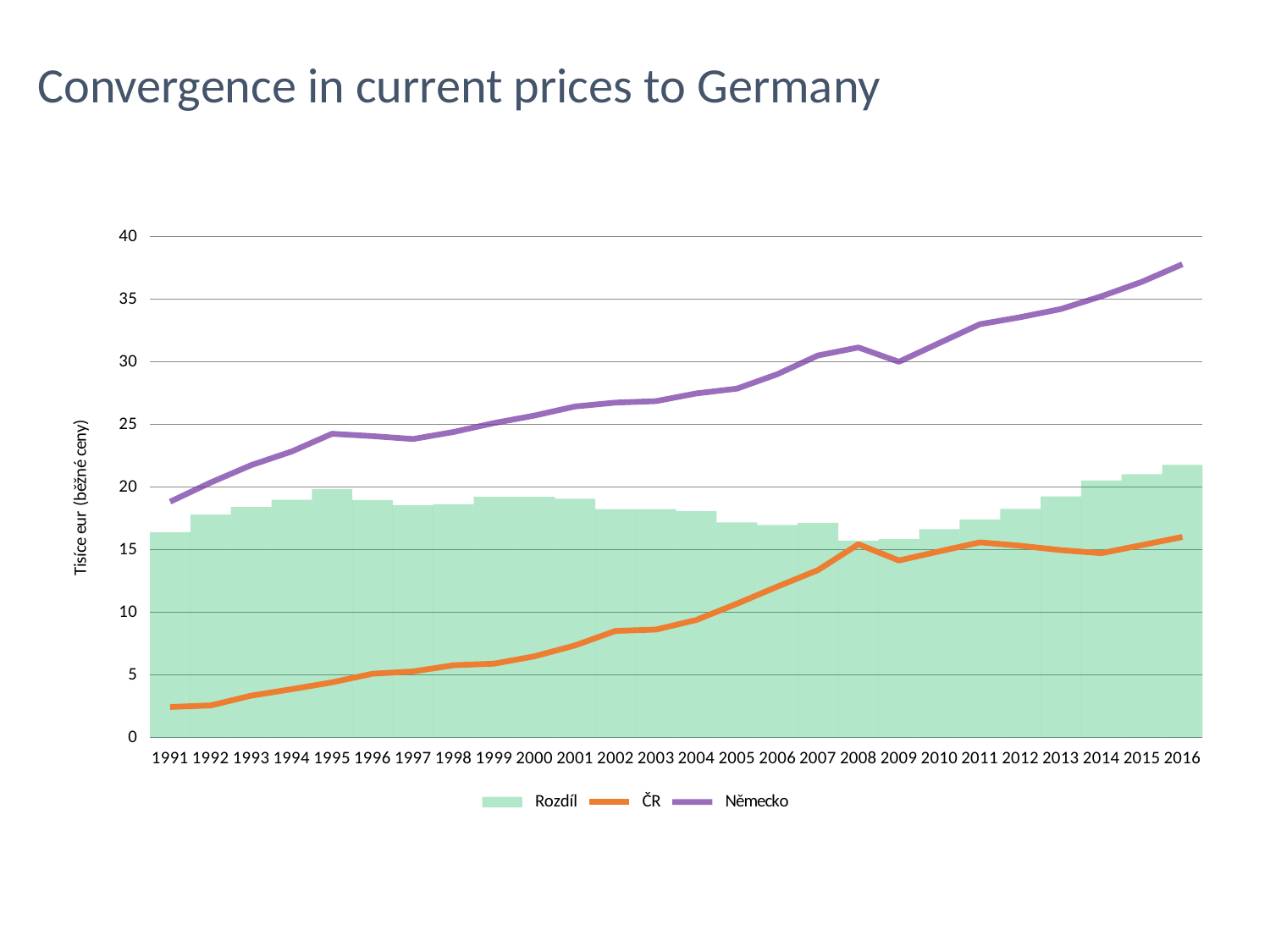
Which is larger in 2016, the value for Německo or the value for ČR? Německo What are the names of the series in the legend? Rozdíl, ČR, Německo In which year is the ČR series at its lowest? 1991 Is the value for ČR in 1991 greater or less than 5? less Is the value for Německo in 2016 greater or less than 35? greater What is the label of the y axis? Tisíce eur (běžné ceny) How many series does the legend list? 3 In which year is the Německo series at its highest? 2016 Is the value for Německo in 2011 greater or less than 30? greater How many years are shown on the x axis? 26 What is the title of the chart? Convergence in current prices to Germany